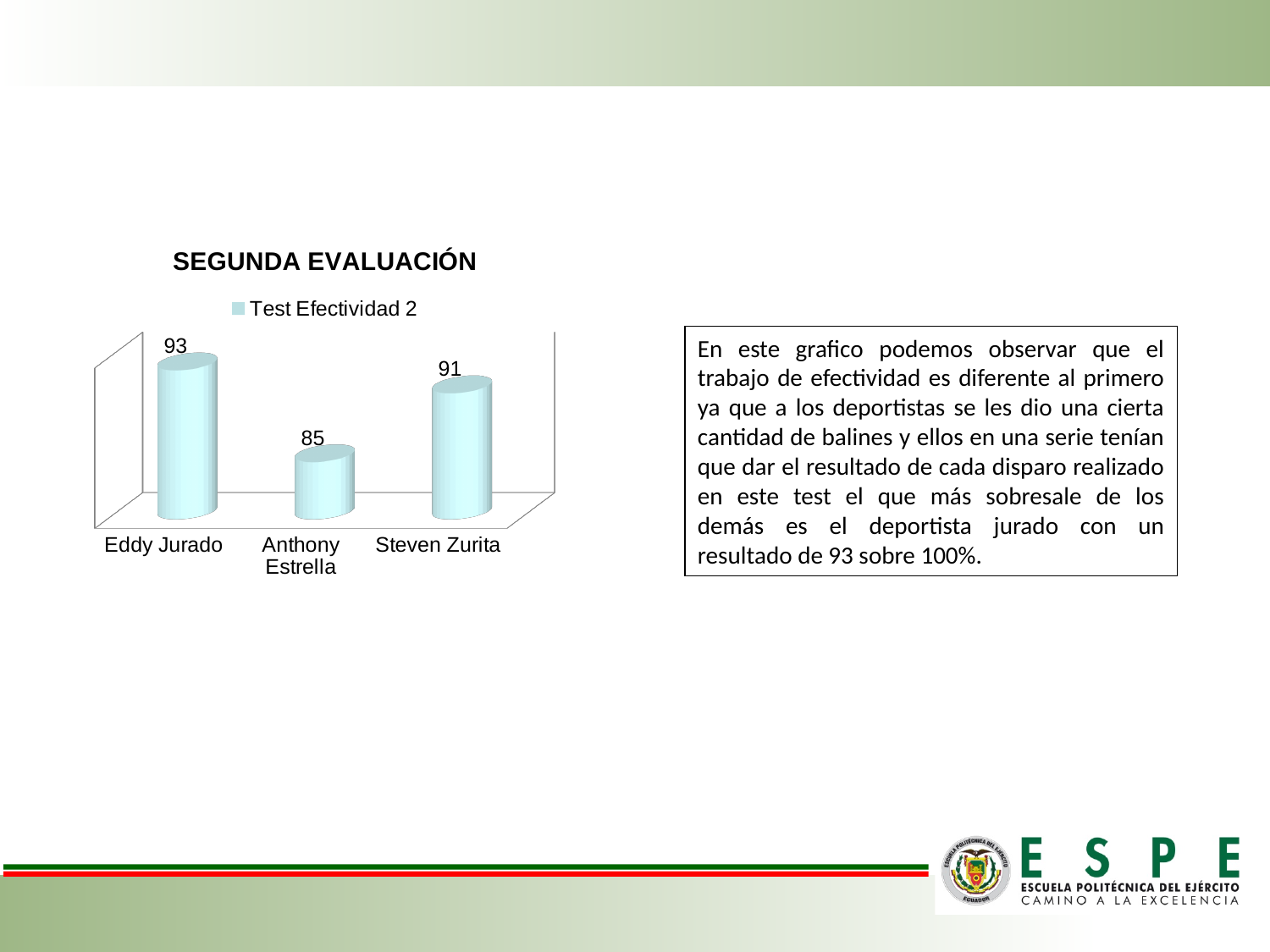
What kind of chart is shown? Bar chart How many categories are shown in the chart? 3 What is the difference between the values for Eddy Jurado and Anthony Estrella? 8 What is the difference between the values for Steven Zurita and Anthony Estrella? 6 Which is larger, the value for Eddy Jurado or the value for Steven Zurita? Eddy Jurado How many series does the legend list? 1 What is the value for Eddy Jurado? 93 What is the value for Anthony Estrella? 85 What is the title of the chart? SEGUNDA EVALUACIÓN Which category has the highest value? Eddy Jurado Which category has the lowest value? Anthony Estrella What is the value for Steven Zurita? 91